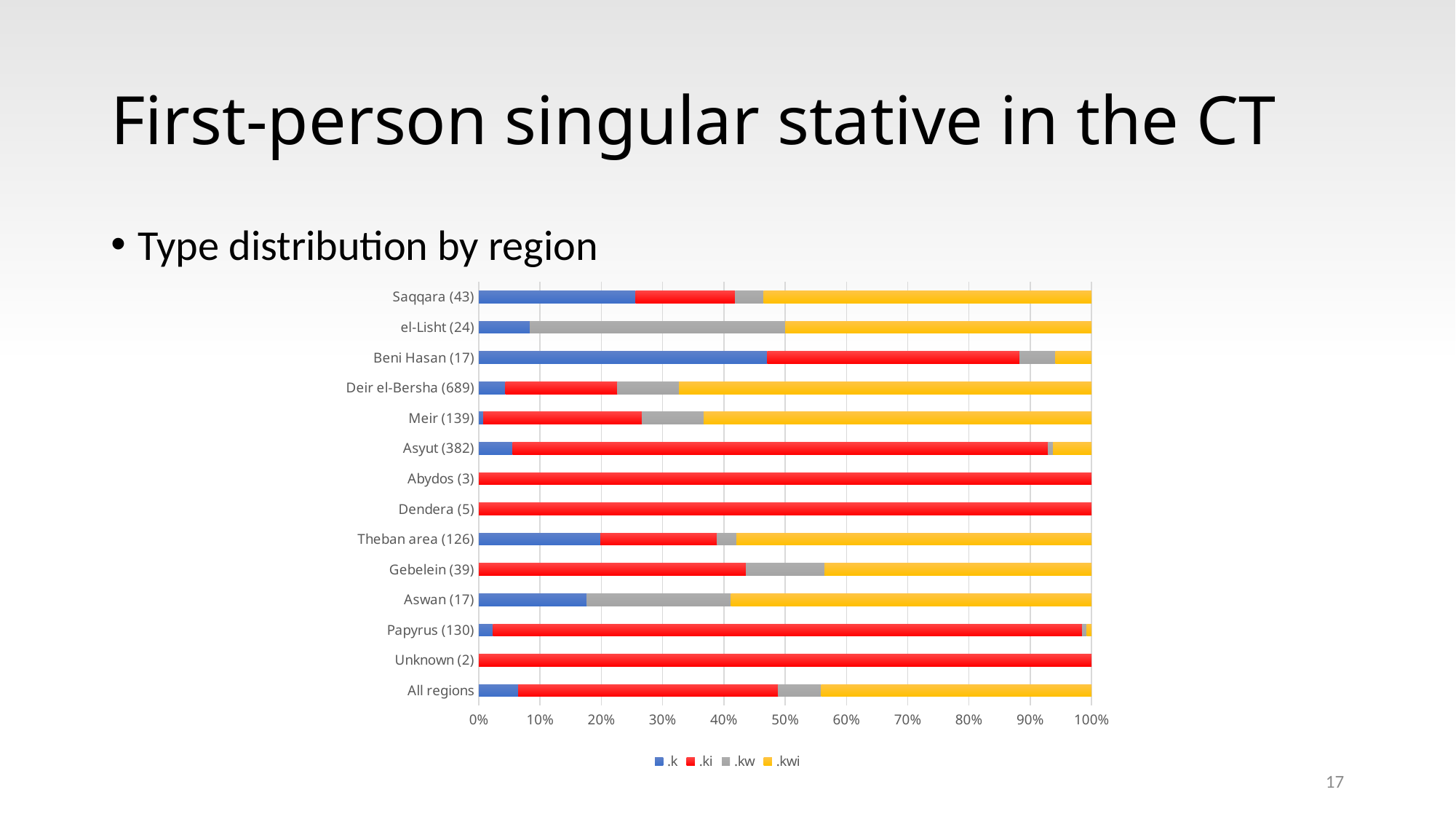
What kind of chart is shown on the slide? stacked bar chart Which region has the larger .kwi share: Aswan (17) or Gebelein (39)? Aswan (17) How many series does the legend list? 4 Is the .k share for Beni Hasan (17) greater or less than 40%? greater What share of the Unknown (2) bar is .ki? 100% What share of the Abydos (3) bar is .ki? 100% Which region has the largest .k share: Beni Hasan (17) or Saqqara (43)? Beni Hasan (17) Is the .k share for el-Lisht (24) greater or less than 10%? less How many regions (categories) are plotted on the chart? 14 What is the label of the bottom-most bar on the chart? All regions Which series does the red colour represent in the legend? .ki Is the .ki share for Asyut (382) greater or less than 80%? greater